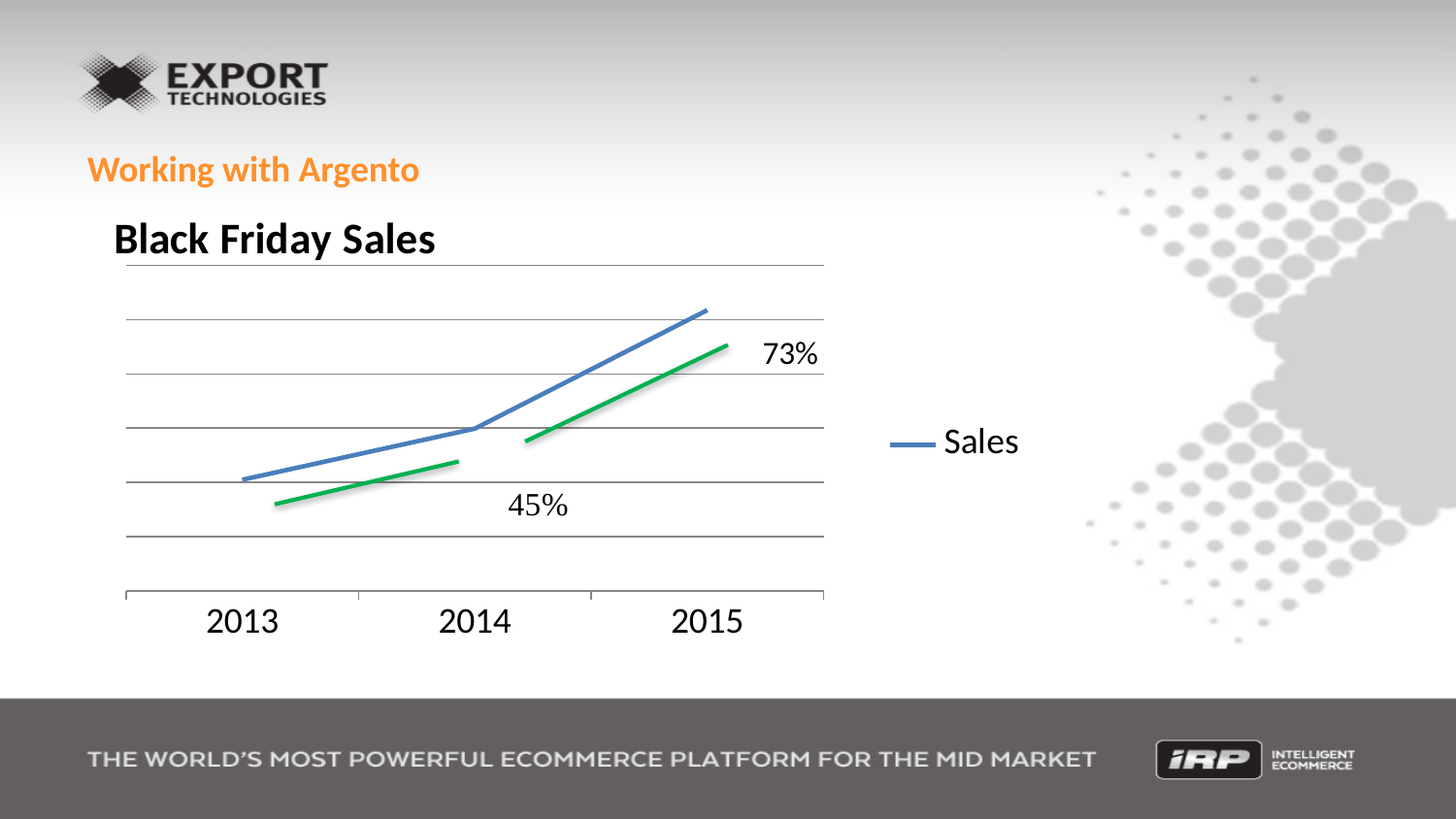
Which year has the lowest Sales value in the Black Friday Sales chart? 2013 Which year has the larger Sales value, 2013 or 2014? 2014 Do the Sales values rise or fall from 2013 to 2015? rise How many years are shown on the x axis of the Black Friday Sales chart? 3 What kind of chart is shown on the slide? line chart Which year has the larger Sales value, 2014 or 2015? 2015 What is the title of the chart on the slide? Black Friday Sales Which year has the highest Sales value in the Black Friday Sales chart? 2015 How many series does the legend of the Black Friday Sales chart list? 1 What is the name of the series listed in the chart's legend? Sales